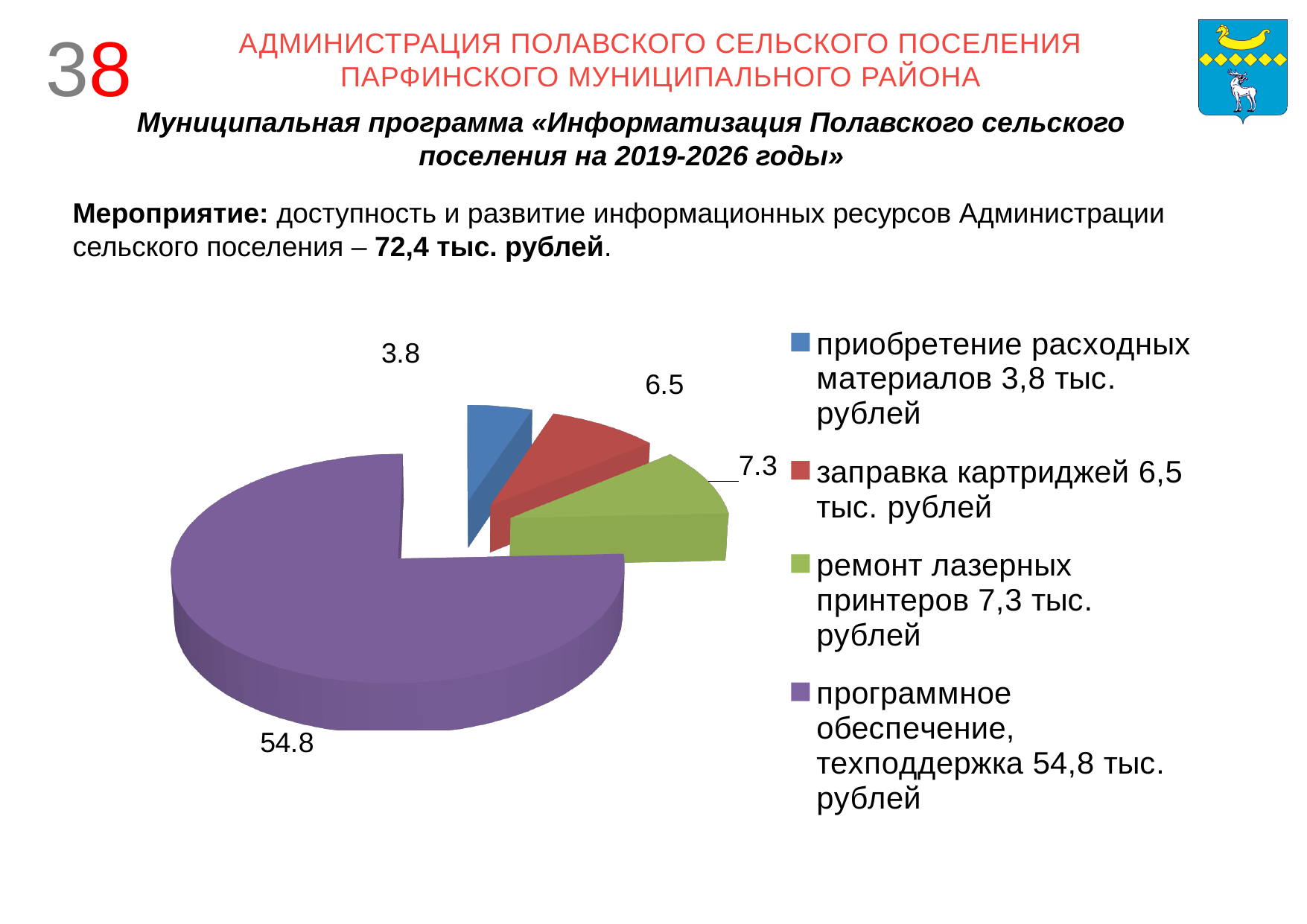
How many slices does the pie chart have? 4 Which is larger: the value for «ремонт лазерных принтеров» or for «заправка картриджей»? ремонт лазерных принтеров What value is shown for the slice «приобретение расходных материалов»? 3.8 What is the total of all four slices of the pie chart? 72.4 What is the difference between the values for «программное обеспечение, техподдержка» and «ремонт лазерных принтеров»? 47.5 What value is shown for the slice «ремонт лазерных принтеров»? 7.3 Which category has the largest slice of the pie? программное обеспечение, техподдержка What kind of chart is shown on the slide? Pie chart What colour is the slice for «программное обеспечение, техподдержка»? Purple What value is shown for the slice «заправка картриджей»? 6.5 What value is shown for the slice «программное обеспечение, техподдержка»? 54.8 Which category has the smallest slice of the pie? приобретение расходных материалов